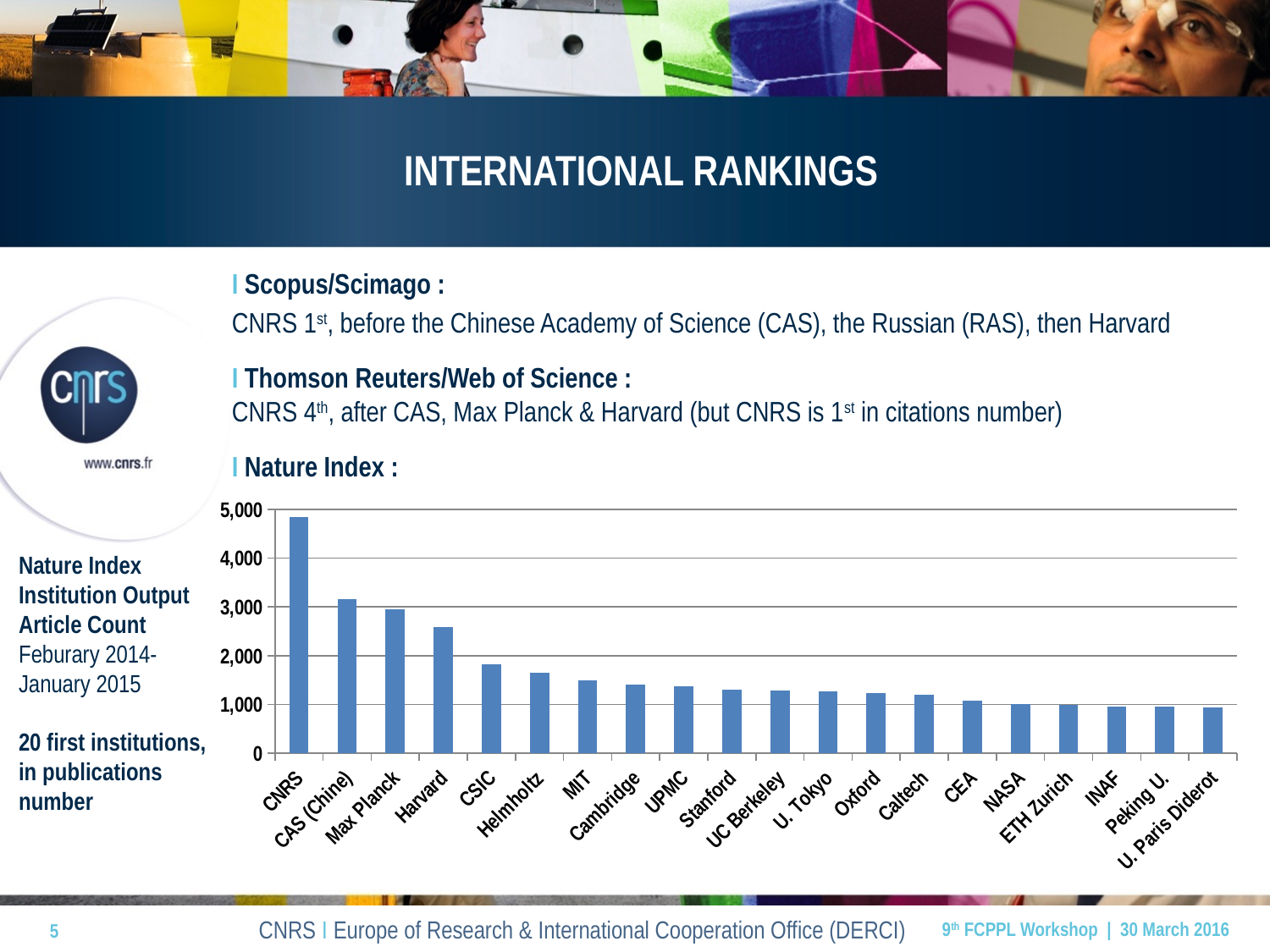
Which is larger, the value for Max Planck or the value for Harvard? Max Planck Which institution has the highest value in the chart? CNRS Is the value for Harvard greater or less than 3,000? less What kind of chart is shown on the slide? bar chart How many institutions are shown on the x axis of the chart? 20 Is the value for CNRS greater or less than 4,000? greater Which is larger, the value for Helmholtz or the value for Stanford? Helmholtz Is the value for CSIC greater or less than 2,000? less What is the highest value shown on the y axis of the chart? 5,000 Do the values rise or fall from left to right along the x axis? fall